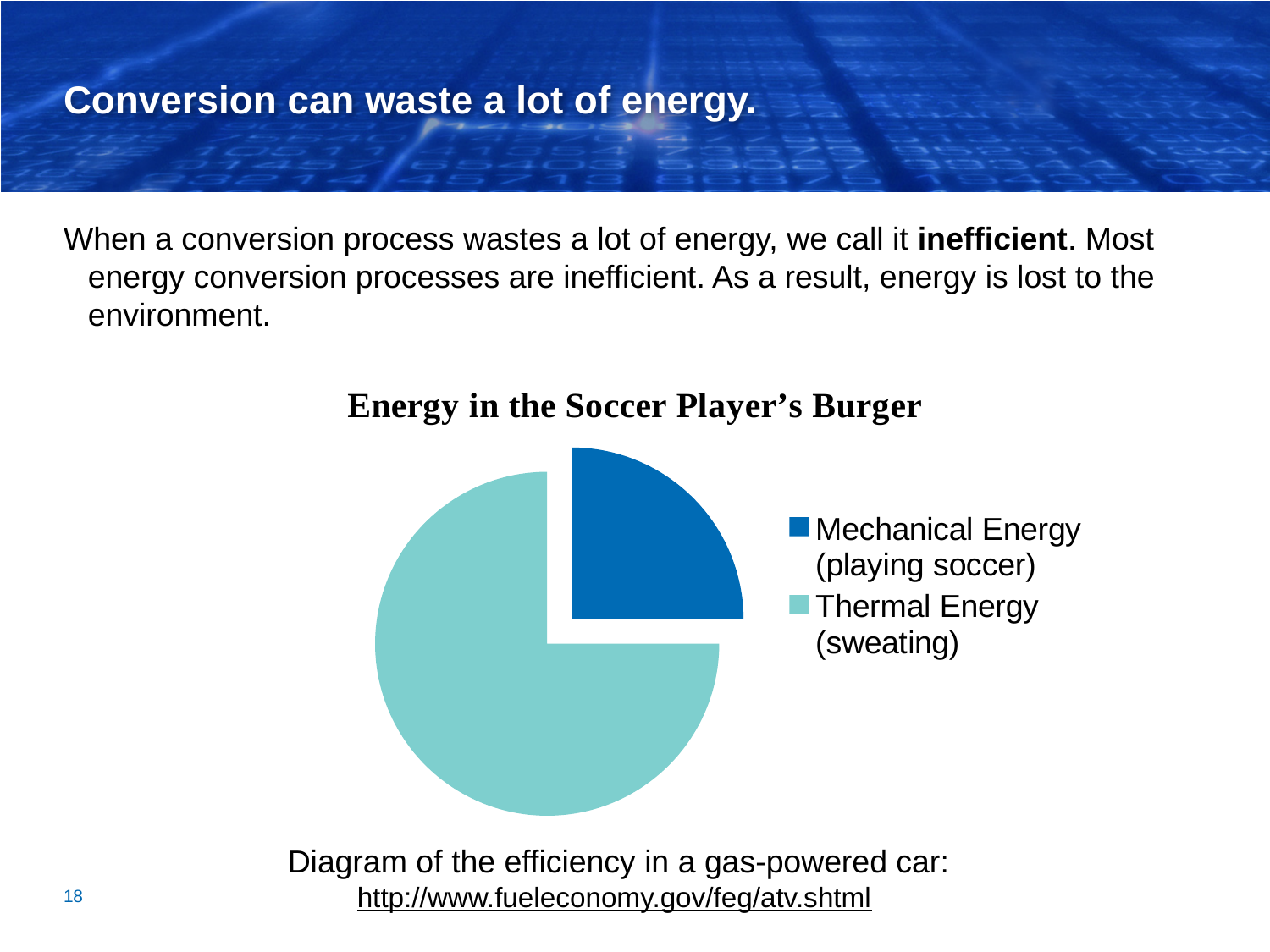
Which is larger in the pie chart, Mechanical Energy (playing soccer) or Thermal Energy (sweating)? Thermal Energy (sweating) What is the title of the chart? Energy in the Soccer Player's Burger Which slice of the pie chart is the largest? Thermal Energy (sweating) Which slice of the pie chart is the smallest? Mechanical Energy (playing soccer) What kind of chart is shown on the slide? pie chart How many slices does the pie chart have? 2 How many entries does the chart's legend list? 2 Which legend entry is shown in dark blue? Mechanical Energy (playing soccer)